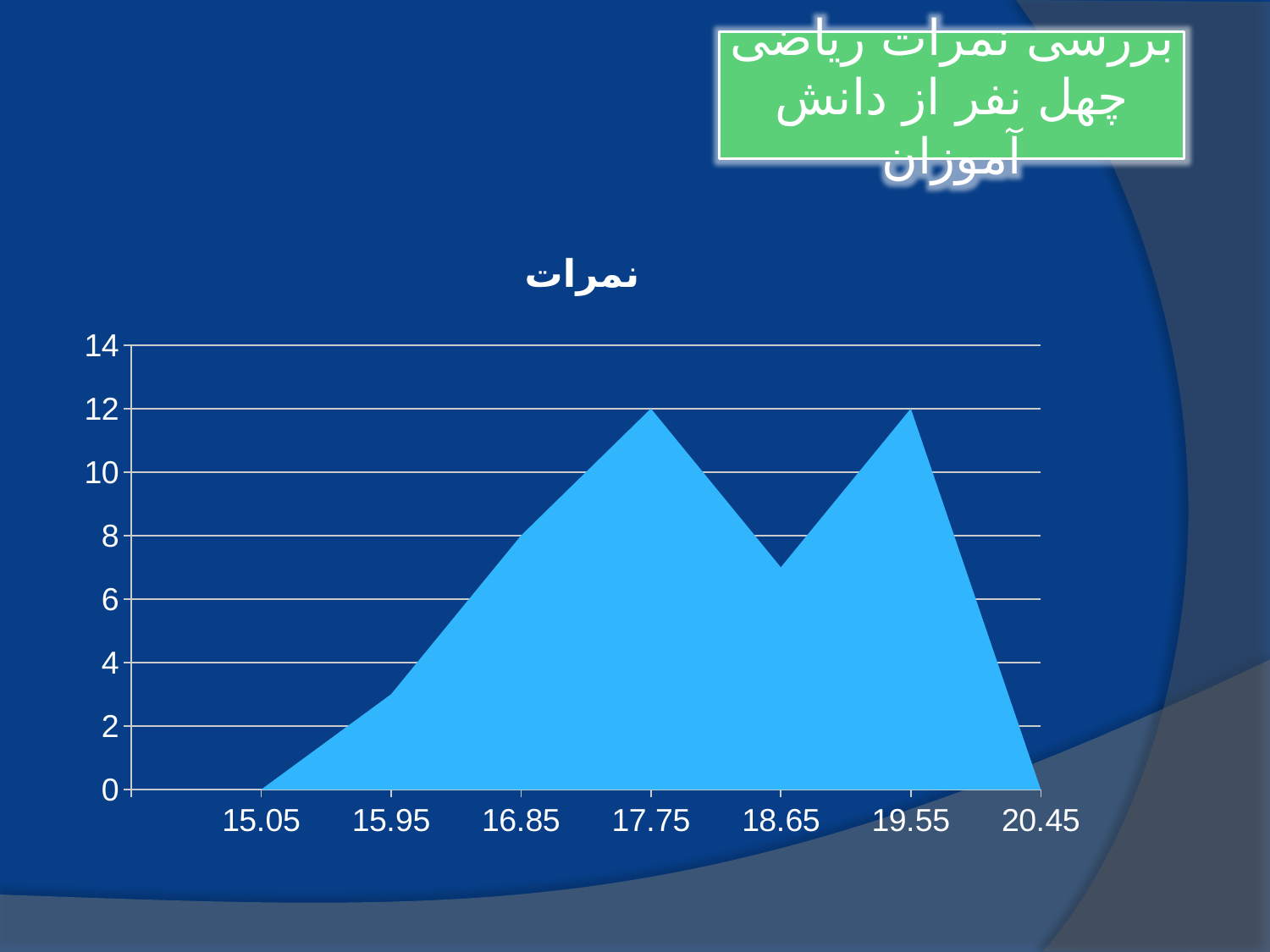
What is the difference between the value at 17.75 and the value at 16.85? 4 Do the values rise or fall from 15.05 to 17.75? rise How many points are plotted along the x axis? 7 What is the value at 17.75? 12 Is the value at 15.95 greater or less than 4? less What is the value at 19.55? 12 What is the value at 20.45? 0 Which is larger, the value at 17.75 or the value at 18.65? 17.75 What kind of chart is shown on the slide? area chart Is the value at 18.65 greater or less than 6? greater What is the value at 16.85? 8 What is the title of the chart? نمرات